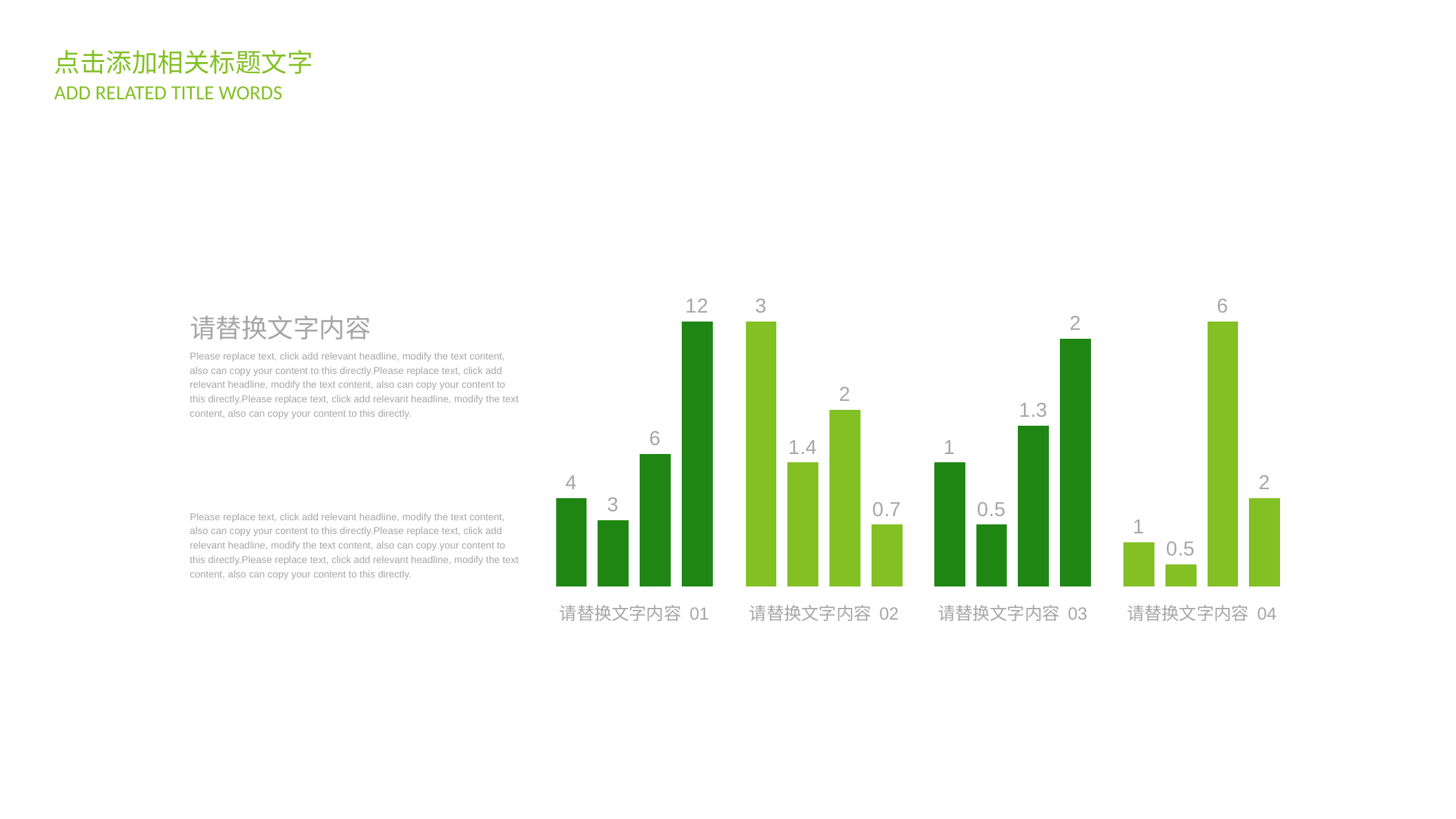
What is the value of the last bar in the group 请替换文字内容 02? 0.7 Which bar has the lowest value in the group 请替换文字内容 04? the second bar (0.5) What is the value of the tallest bar in the group 请替换文字内容 01? 12 What is the difference between the highest and lowest values in the group 请替换文字内容 01? 9 Which is larger: the third bar in group 请替换文字内容 04 or the fourth bar in group 请替换文字内容 03? the third bar in group 04 (6) What is the total of the four values in the group 请替换文字内容 03? 4.8 How many bars are in the group labelled 请替换文字内容 01? 4 What type of chart is shown on the slide? bar chart What is the value of the first bar in the group 请替换文字内容 02? 3 What is the difference between the second bar (1.4) and the fourth bar (0.7) in the group 请替换文字内容 02? 0.7 What is the value of the third bar in the group 请替换文字内容 03? 1.3 How many category groups are shown along the x axis of the chart? 4